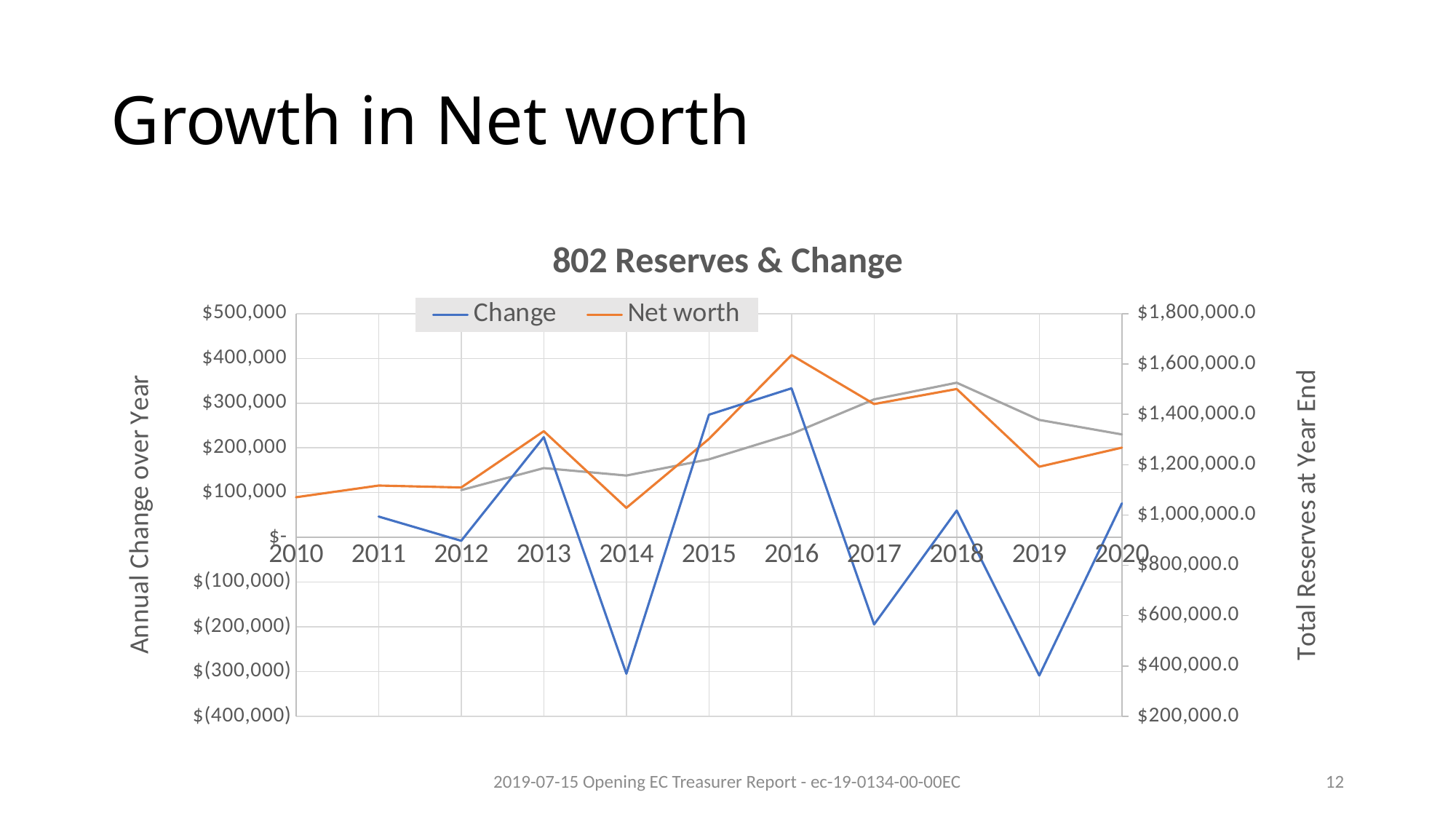
What is the title of the right-hand vertical axis? Total Reserves at Year End Is the Net worth value for 2016 greater or less than $1,400,000.0? greater What kind of chart is shown on the slide? line chart Does the Net worth series rise or fall from 2010 to 2013? rise In which year does the Net worth series reach its highest value? 2016 Is the Change value for 2016 greater or less than $300,000? greater How many series does the chart legend list? 2 What is the title of the chart? 802 Reserves & Change Is the Change value for 2014 greater or less than $(200,000)? less In which year does the Change series reach its highest value? 2016 Which year has the larger Change value, 2013 or 2015? 2015 How many years are shown along the x axis of the chart? 11